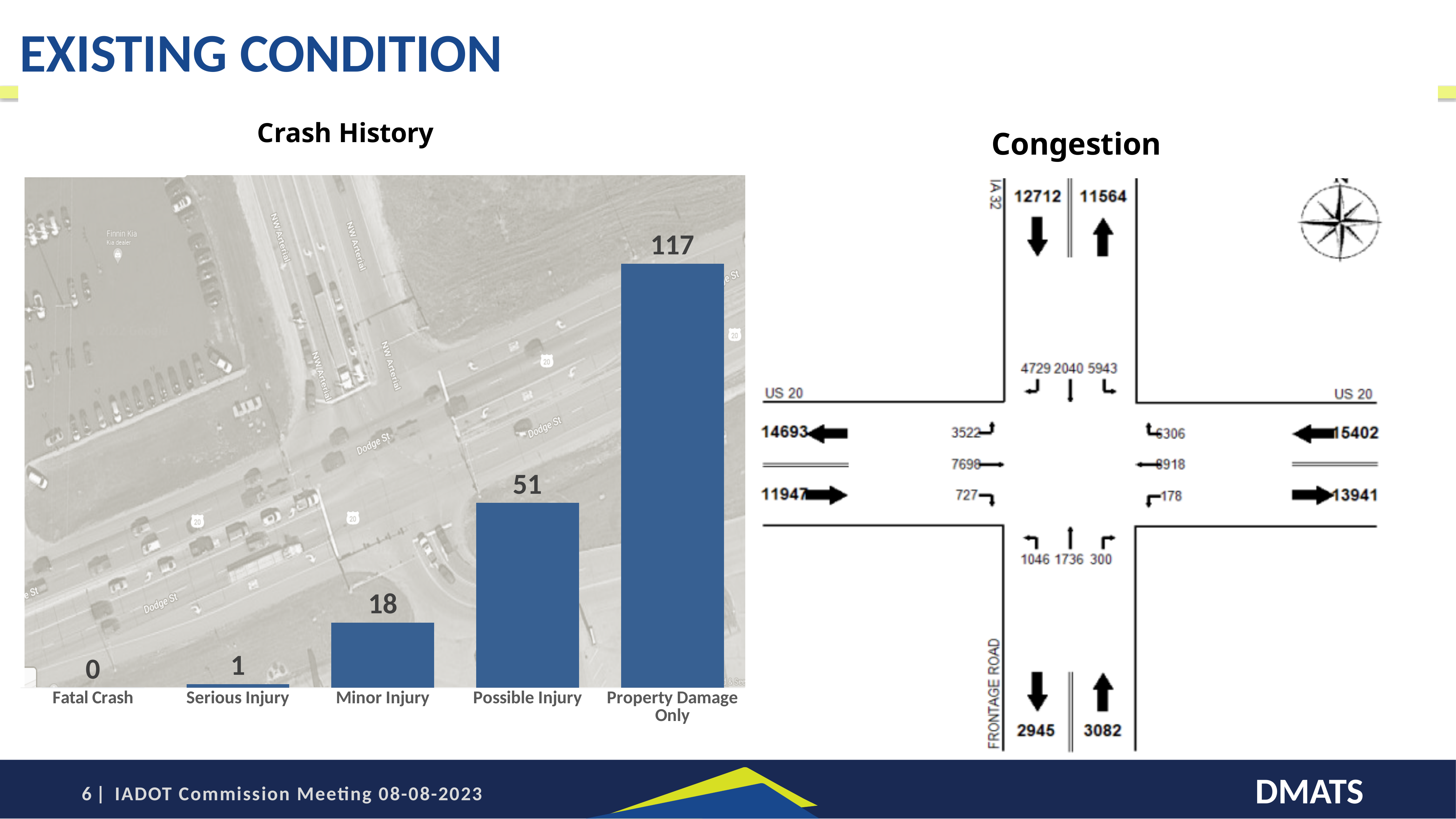
In the Crash History chart, which category has the lowest value? Fatal Crash In the Crash History chart, what is the difference between Possible Injury and Minor Injury? 33 In the Crash History chart, what is the value for Serious Injury? 1 In the Crash History chart, what is the value for Possible Injury? 51 How many categories does the Crash History chart show? 5 In the Crash History chart, what is the value for Fatal Crash? 0 What type of chart is the Crash History chart? Bar chart In the Crash History chart, what is the difference between Property Damage Only and Possible Injury? 66 In the Crash History chart, how many crashes are shown for Property Damage Only? 117 In the Crash History chart, which category has the highest value? Property Damage Only In the Crash History chart, which is larger, Minor Injury or Possible Injury? Possible Injury In the Crash History chart, what is the value for Minor Injury? 18